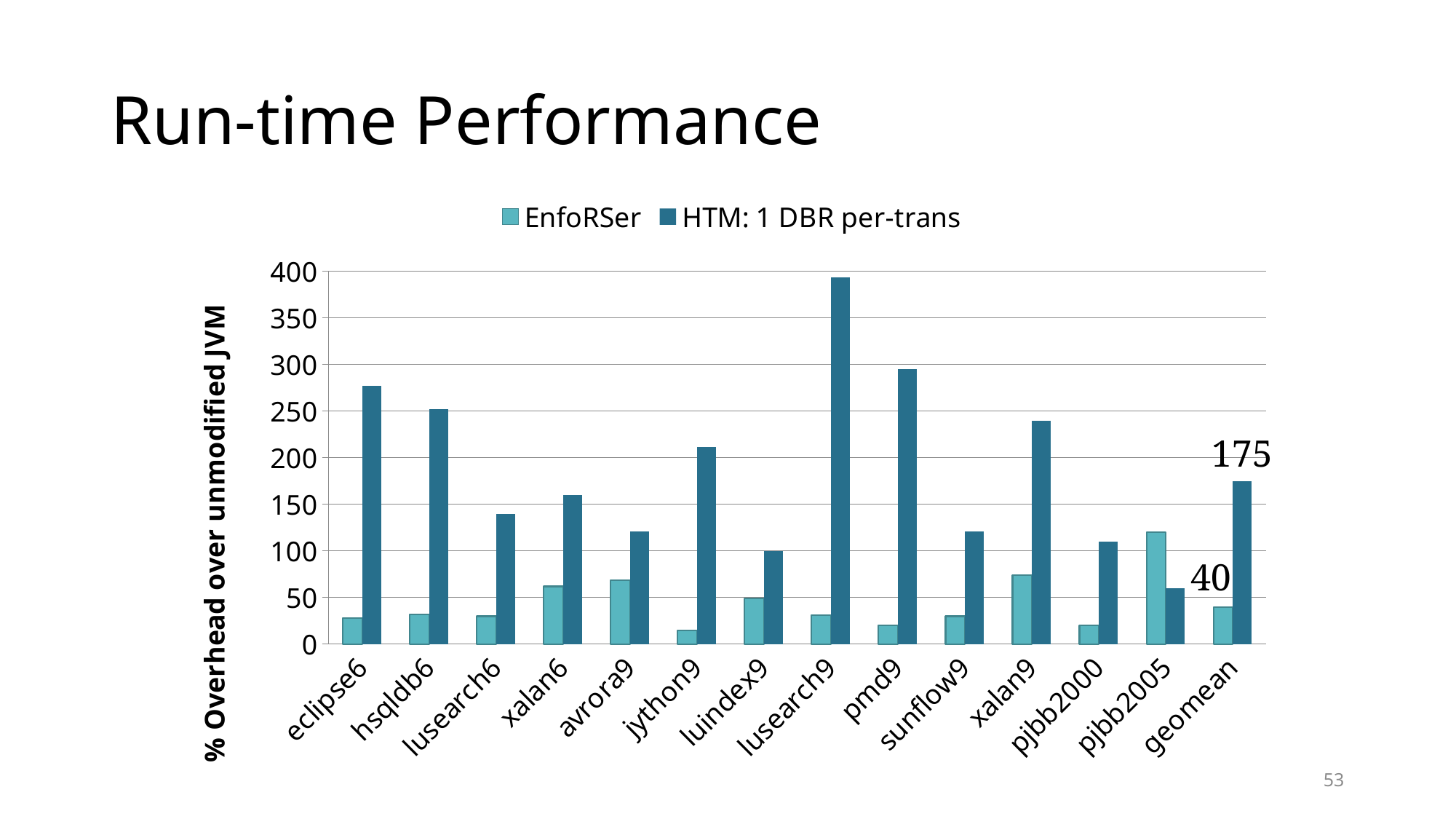
Which category has the lowest EnfoRSer value? jython9 How many series does the legend list? 2 Which category has the highest HTM: 1 DBR per-trans value? lusearch9 What is the label of the y axis? % Overhead over unmodified JVM What is the EnfoRSer value for geomean? 40 Which category has the highest EnfoRSer value? pjbb2005 What type of chart is shown on the slide? bar chart How many benchmark categories are shown on the x axis? 14 What is the HTM: 1 DBR per-trans value for geomean? 175 Is the HTM: 1 DBR per-trans value for lusearch9 greater or less than 350? greater For pjbb2005, which is larger: the EnfoRSer value or the HTM: 1 DBR per-trans value? EnfoRSer What is the difference between the HTM: 1 DBR per-trans and EnfoRSer values for geomean? 135